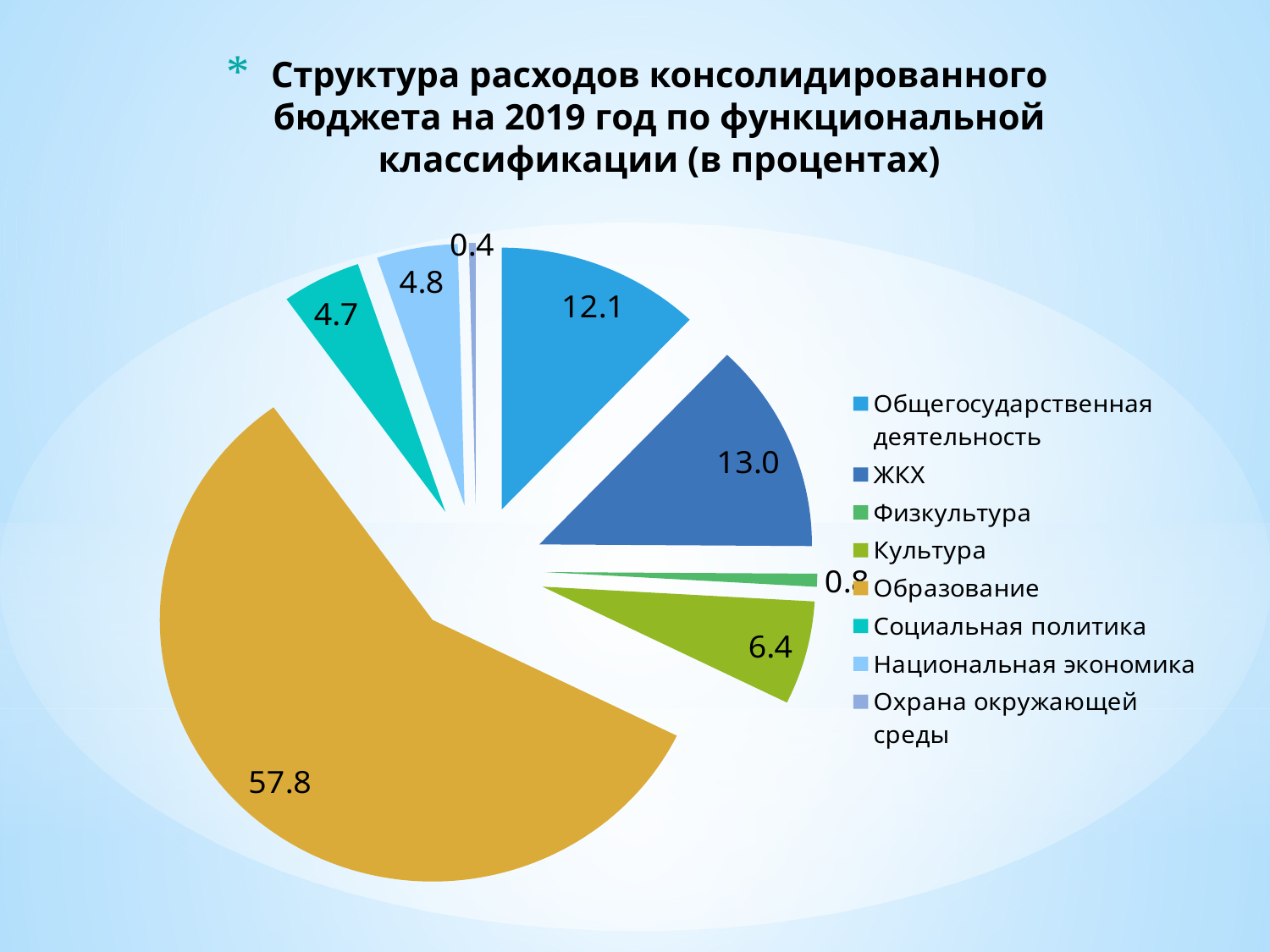
What is the difference between the values for ЖКХ and Общегосударственная деятельность? 0.9 What is the value for Общегосударственная деятельность in the pie chart? 12.1 Which category has the smallest slice of the pie chart? Охрана окружающей среды What is the value for Социальная политика in the pie chart? 4.7 Which is larger in the pie chart, Образование or ЖКХ? Образование What is the value for ЖКХ in the pie chart? 13.0 How many categories does the legend of the pie chart list? 8 What is the value for Образование in the pie chart? 57.8 What is the value for Охрана окружающей среды in the pie chart? 0.4 What is the value for Культура in the pie chart? 6.4 What kind of chart is shown on the slide? Pie chart Which category has the largest slice of the pie chart? Образование